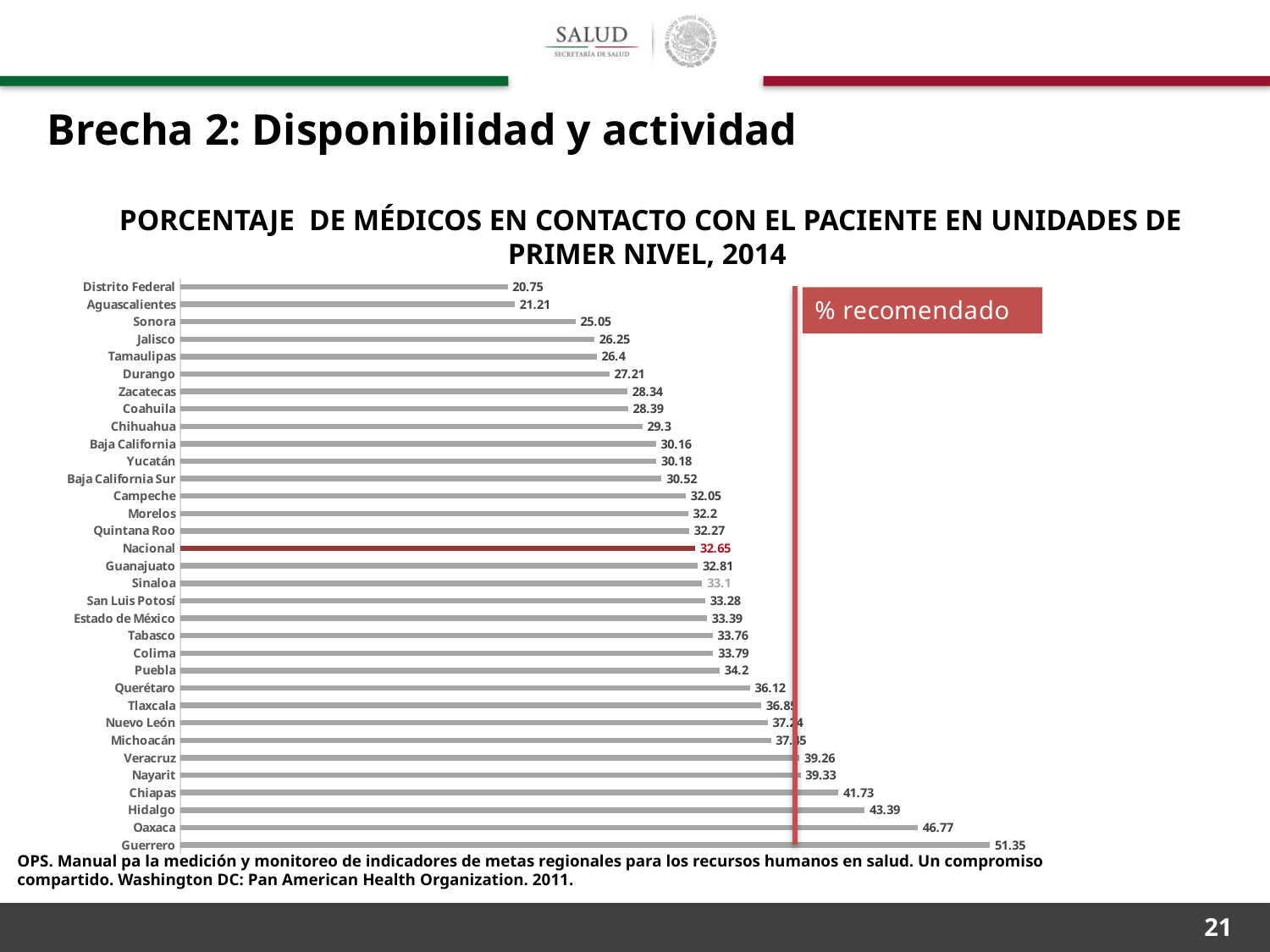
What is the difference between the values for Guerrero and Oaxaca? 4.58 What does the red vertical line in the chart represent? % recomendado What is the value for Nacional? 32.65 Which category has the lowest value? Distrito Federal What is the value for Oaxaca? 46.77 What kind of chart is shown on the slide? Bar chart What is the difference between the values for Nacional and Distrito Federal? 11.9 Which category has the highest value? Guerrero How many categories are shown in the chart? 33 What is the value for Sonora? 25.05 Which bar is highlighted in red? Nacional Which has a larger value, Chiapas or Hidalgo? Hidalgo